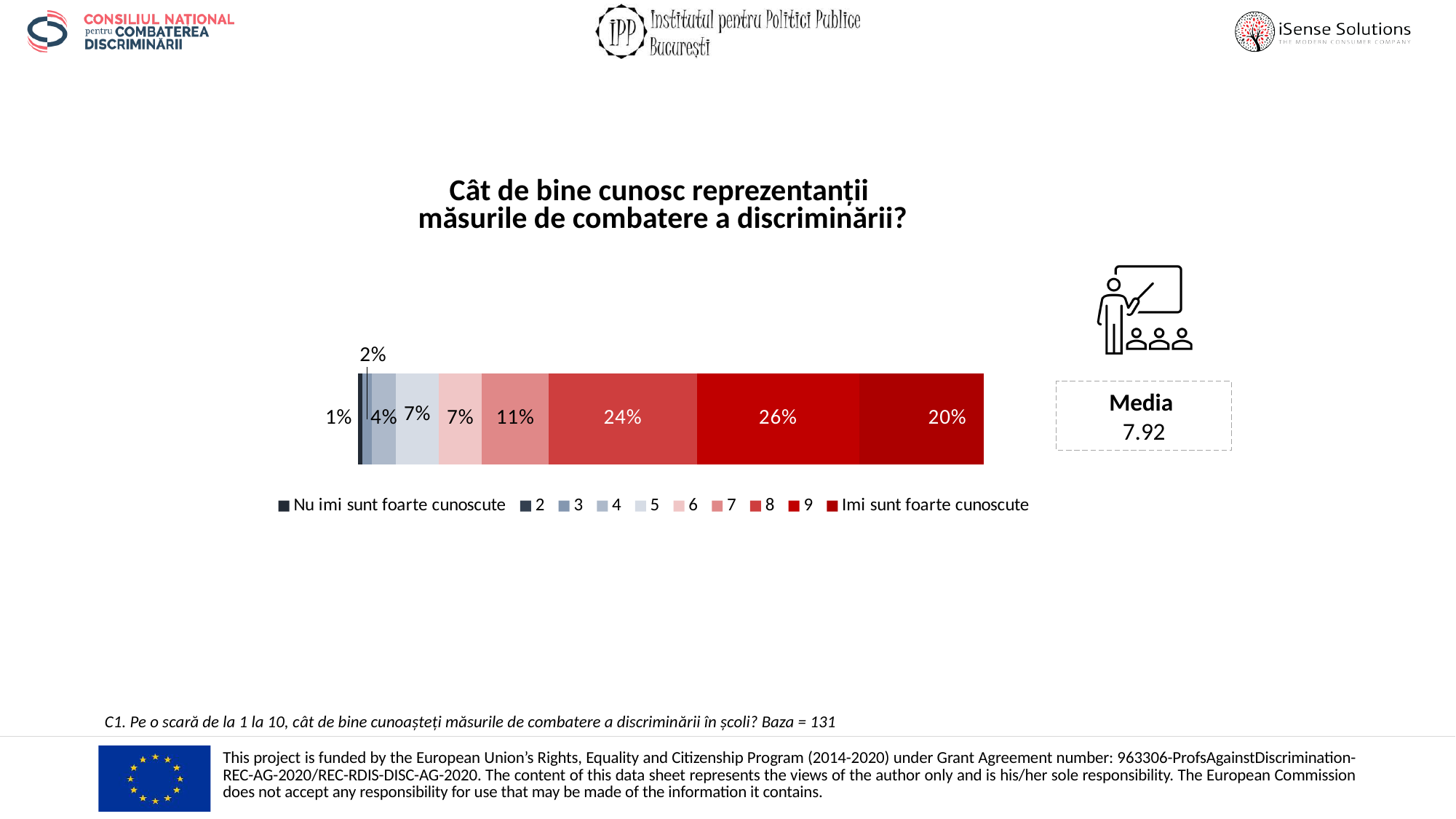
What is the value for 'Imi sunt foarte cunoscute'? 20% What is the title of the chart? Cât de bine cunosc reprezentanții măsurile de combatere a discriminării? What is the largest value shown in the stacked bar? 26% What is the value for 'Nu imi sunt foarte cunoscute'? 1% What is the smallest value labelled in the stacked bar? 1% What type of chart is shown on the slide? Stacked bar chart Which is larger: the 'Imi sunt foarte cunoscute' segment or the 'Nu imi sunt foarte cunoscute' segment? Imi sunt foarte cunoscute What is the 'Media' (mean) value shown next to the chart? 7.92 What is the base (Baza) stated for question C1? 131 What is the difference between the largest segment (26%) and the 'Imi sunt foarte cunoscute' segment? 6 percentage points How many series does the legend list? 10